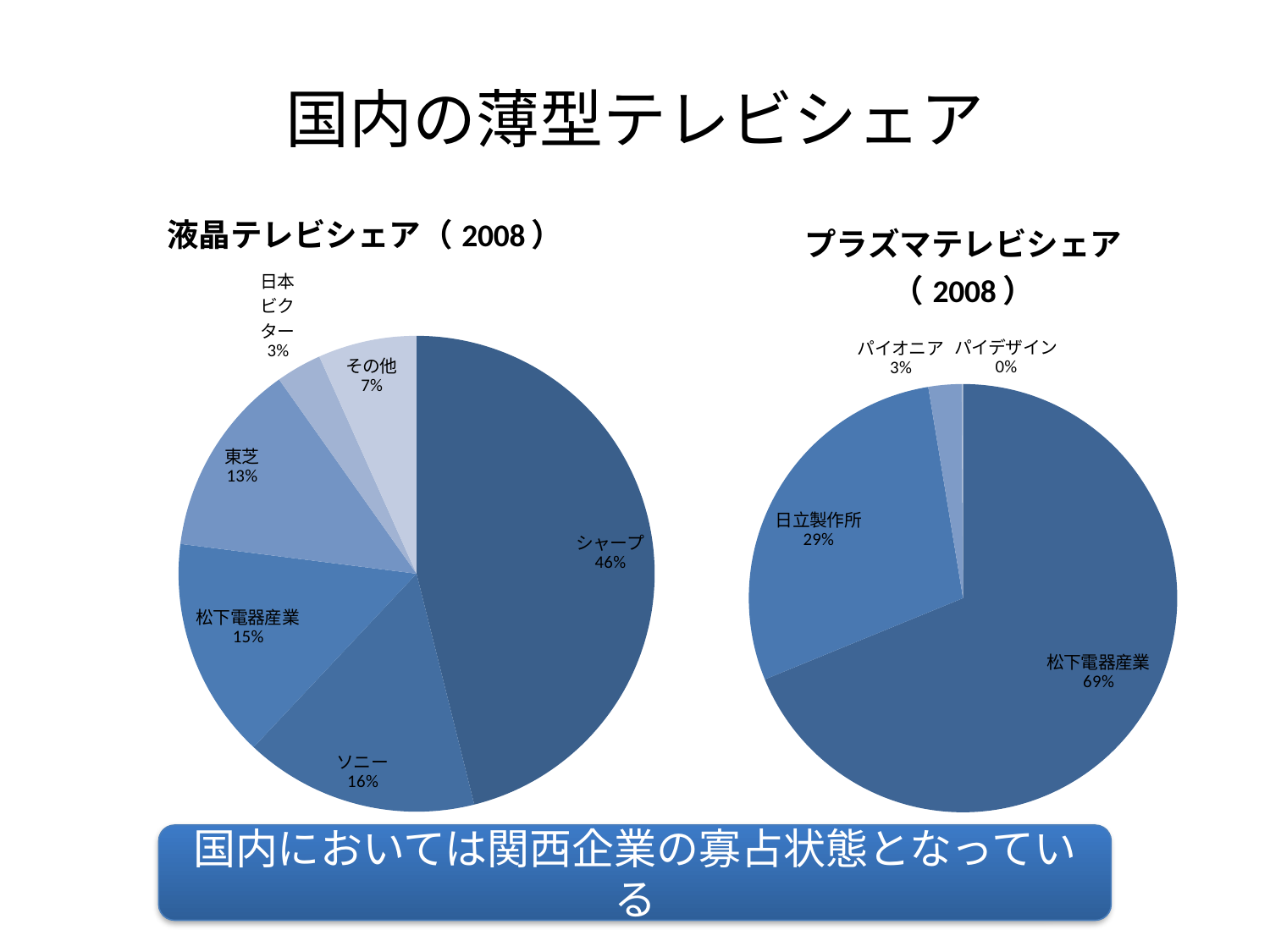
In the プラズマテレビシェア（2008） chart, what is the difference between the shares of 松下電器産業 and 日立製作所? 40% In the 液晶テレビシェア（2008） chart, which category has the smallest share? 日本ビクター What type of chart is used for the two charts on the slide? Pie chart In the プラズマテレビシェア（2008） chart, what share does 日立製作所 have? 29% In the 液晶テレビシェア（2008） chart, what share does シャープ have? 46% In the 液晶テレビシェア（2008） chart, what share does 東芝 have? 13% In the プラズマテレビシェア（2008） chart, what share does 松下電器産業 have? 69% In the 液晶テレビシェア（2008） chart, what is the difference between the shares of シャープ and ソニー? 30% In the プラズマテレビシェア（2008） chart, which is larger, the share of パイオニア or パイデザイン? パイオニア In the 液晶テレビシェア（2008） chart, which company has the largest share? シャープ In the プラズマテレビシェア（2008） chart, which company has the largest share? 松下電器産業 In the 液晶テレビシェア（2008） chart, how many slices does the pie have? 6